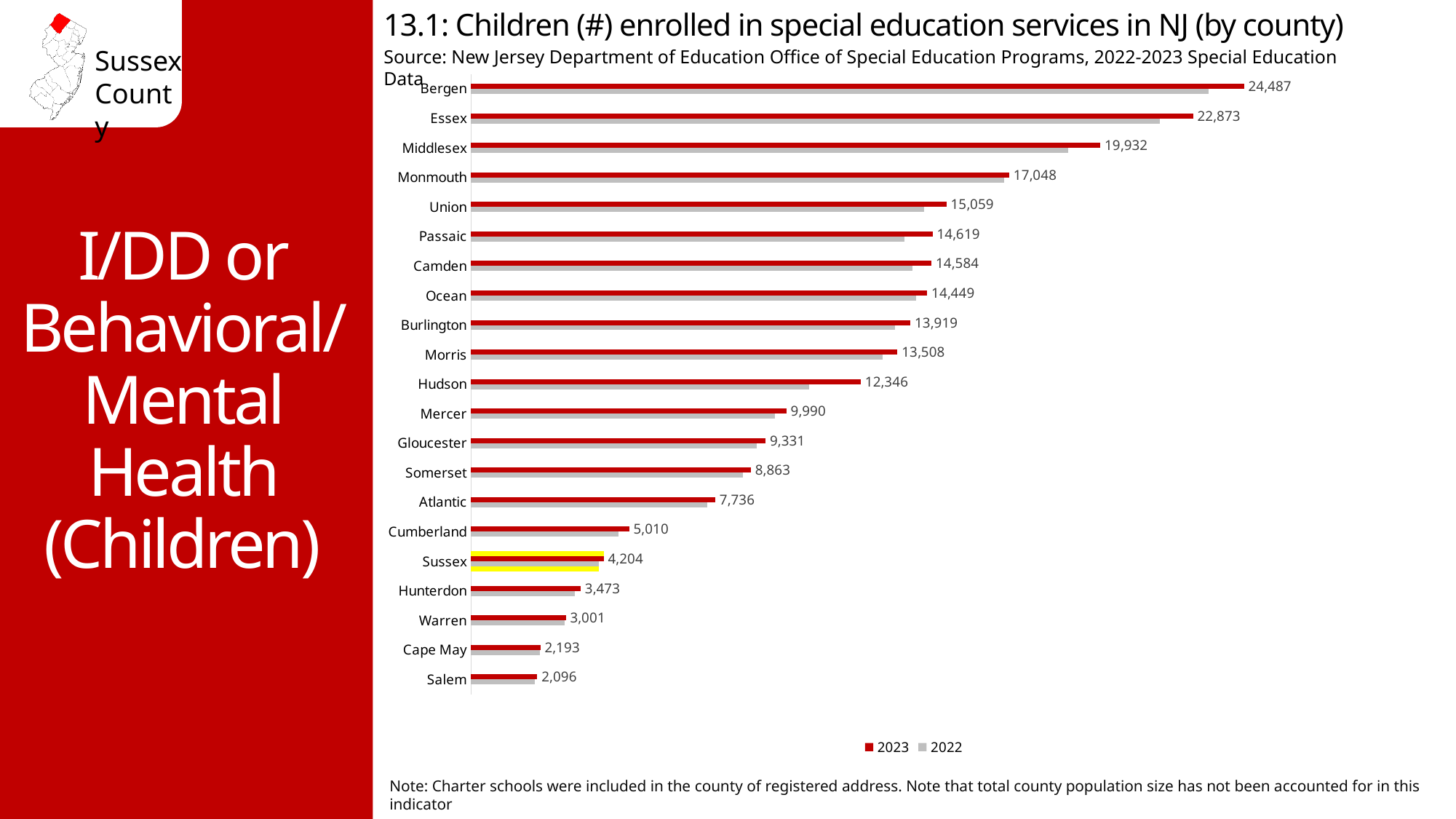
Which year does the red series in the legend represent? 2023 Which county has the highest number of children enrolled in special education services in 2023? Bergen What is the difference between the 2023 values for Sussex and Hunterdon? 731 Which county has the lowest number of children enrolled in special education services in 2023? Salem How many counties are shown in the chart? 21 What is the 2023 value for Bergen county? 24,487 Which county has a larger 2023 value, Mercer or Gloucester? Mercer What is the 2023 value for Sussex county? 4,204 What kind of chart is shown on the slide? Bar chart How many series does the legend list? 2 What is the 2023 value for Cumberland county? 5,010 What is the difference between the 2023 values for Bergen and Essex? 1,614